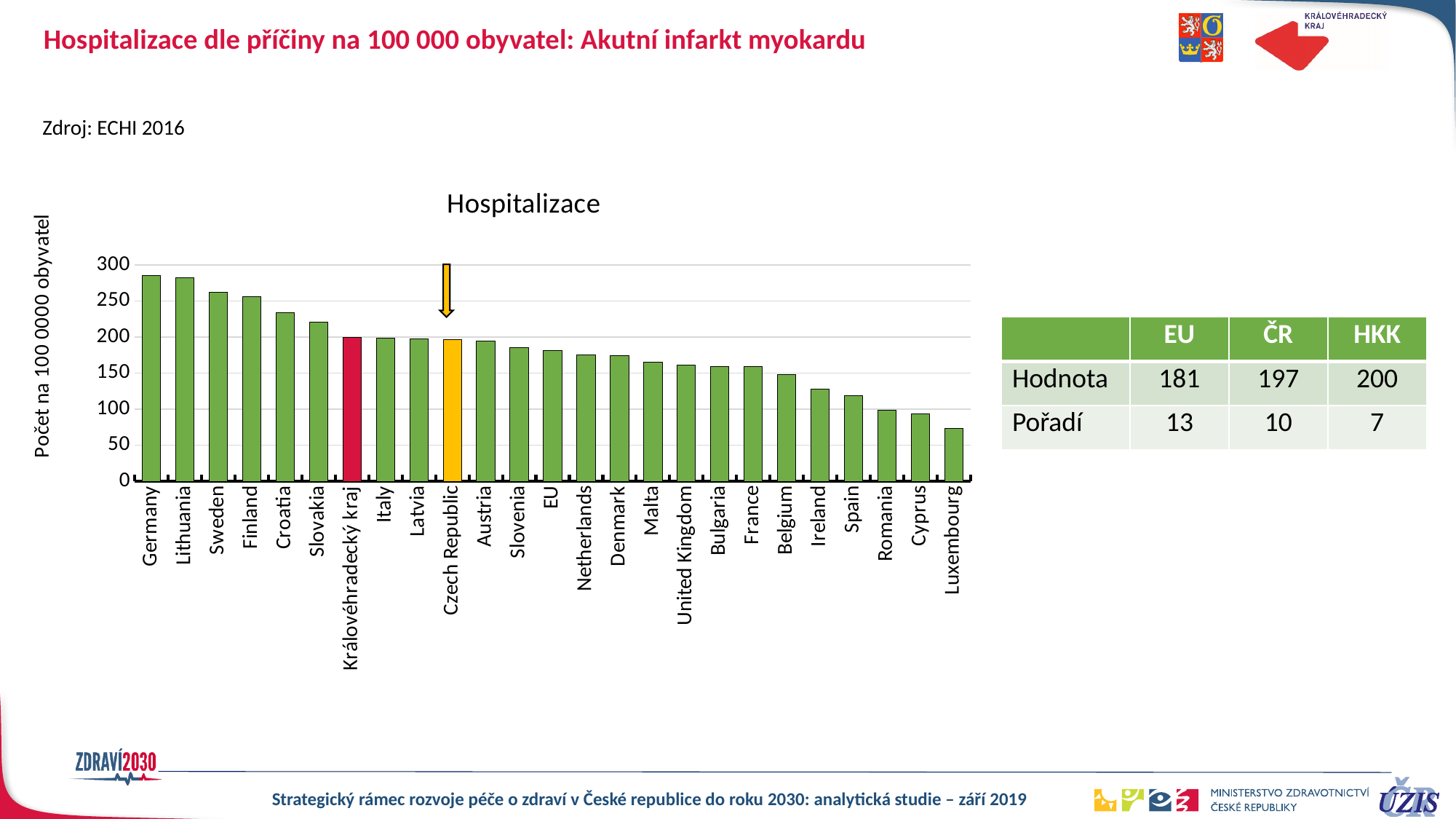
Is the value for Luxembourg greater or less than 100? less Do the values rise or fall from left to right along the x axis? fall What kind of chart is shown on the slide? bar chart Is the value for Germany greater or less than 250? greater How many categories (bars) are plotted in the chart? 25 What is the difference between the HKK value and the EU value in the table? 19 According to the table, what is the value (Hodnota) for EU? 181 According to the table, what is the value (Hodnota) for HKK? 200 Which country has the highest hospitalization rate in the chart? Germany Which country has the lowest hospitalization rate in the chart? Luxembourg What colour is the bar for Královéhradecký kraj? red According to the table, what is the rank (Pořadí) of ČR? 10